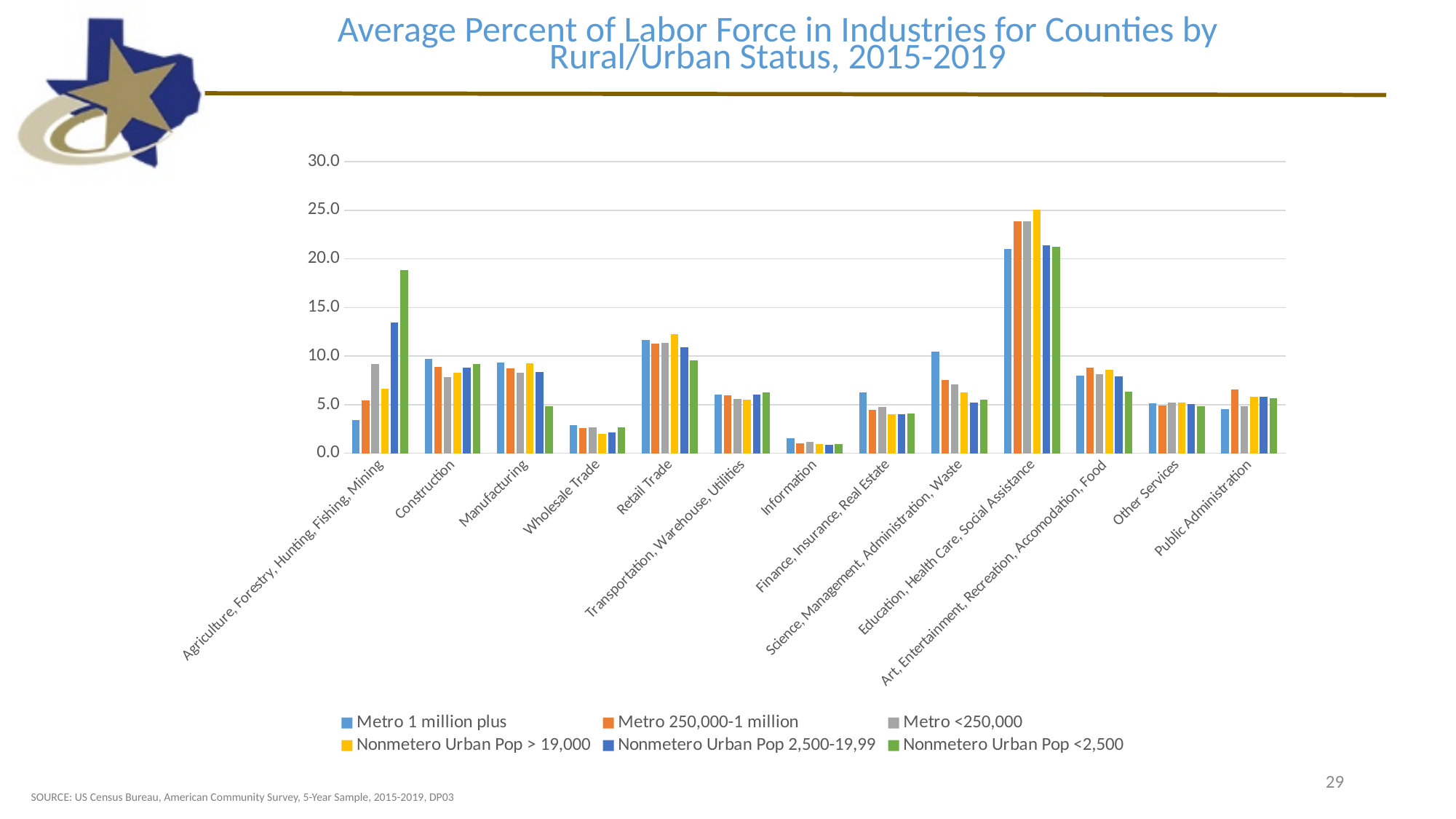
How many series does the legend list? 6 Is the value for Nonmetero Urban Pop > 19,000 in Education, Health Care, Social Assistance greater or less than 20.0? greater Which industry has the lowest value for the Metro 1 million plus series? Information Is the value for Nonmetero Urban Pop <2,500 in Agriculture, Forestry, Hunting, Fishing, Mining greater or less than 15.0? greater In Science, Management, Administration, Waste, which is larger: Metro 1 million plus or Nonmetero Urban Pop <2,500? Metro 1 million plus Which industry has the highest value for the Metro 1 million plus series? Education, Health Care, Social Assistance Is the value for Metro 1 million plus in Agriculture, Forestry, Hunting, Fishing, Mining greater or less than 5.0? less How many industry categories are shown on the x axis? 13 What colour represents the Nonmetero Urban Pop <2,500 series in the legend? Green In Agriculture, Forestry, Hunting, Fishing, Mining, which is larger: Metro 1 million plus or Nonmetero Urban Pop <2,500? Nonmetero Urban Pop <2,500 Which industry has the highest value for the Nonmetero Urban Pop <2,500 series? Education, Health Care, Social Assistance What kind of chart is shown on the slide? Bar chart